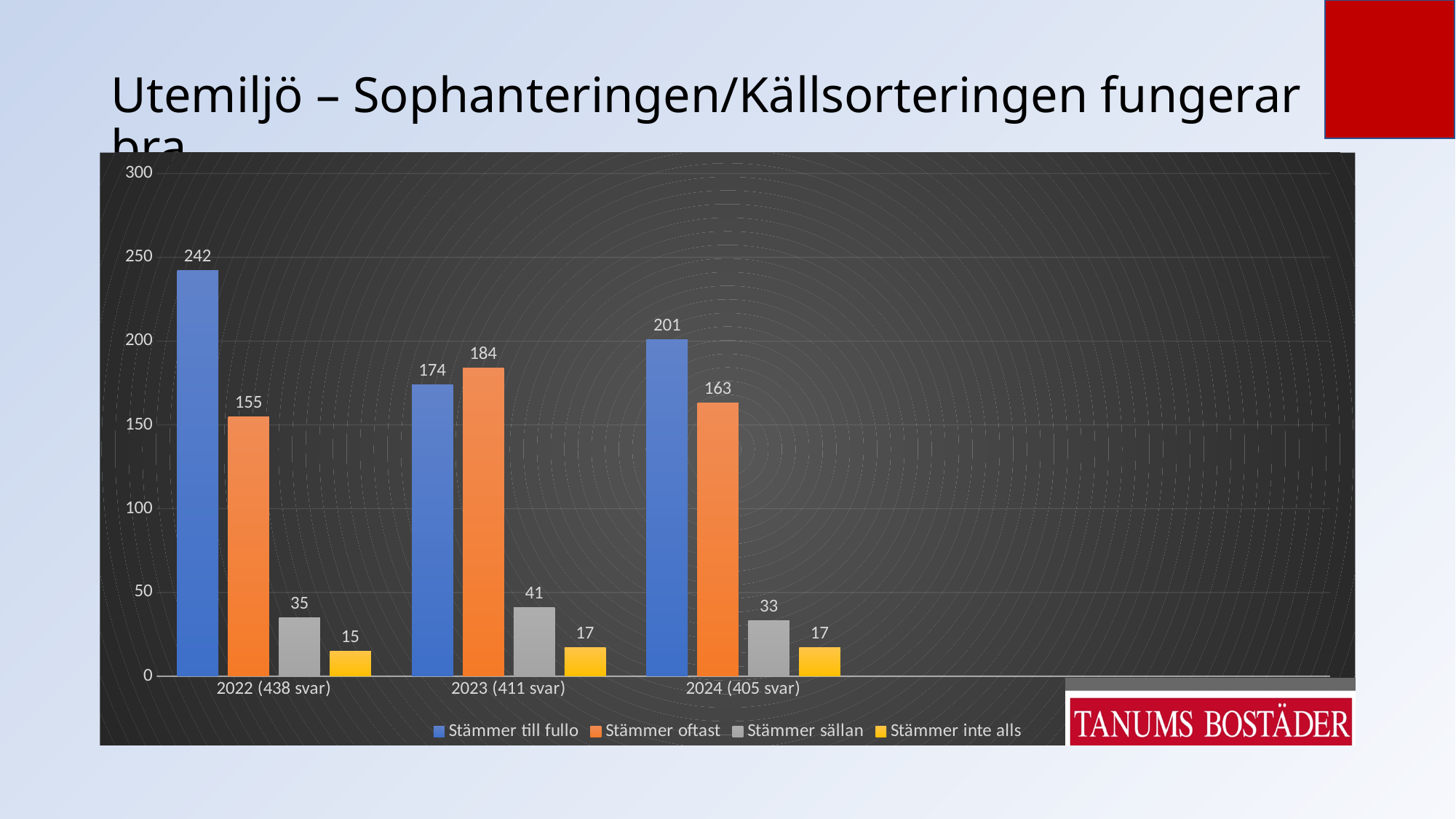
What is the value for "Stämmer oftast" in 2023 (411 svar)? 184 What is the value for "Stämmer sällan" in 2024 (405 svar)? 33 What kind of chart is shown on the slide? Bar chart How many year categories are shown on the x axis? 3 What is the value for "Stämmer till fullo" in 2022 (438 svar)? 242 What is the value for "Stämmer inte alls" in 2022 (438 svar)? 15 Which year has the highest value for "Stämmer till fullo"? 2022 (438 svar) How many series does the legend list? 4 Which is larger in 2023: "Stämmer till fullo" or "Stämmer oftast"? Stämmer oftast What is the total of all four responses for 2024 (405 svar)? 414 Which year has the lowest value for "Stämmer inte alls"? 2022 (438 svar) What is the difference between "Stämmer till fullo" in 2022 and in 2024? 41